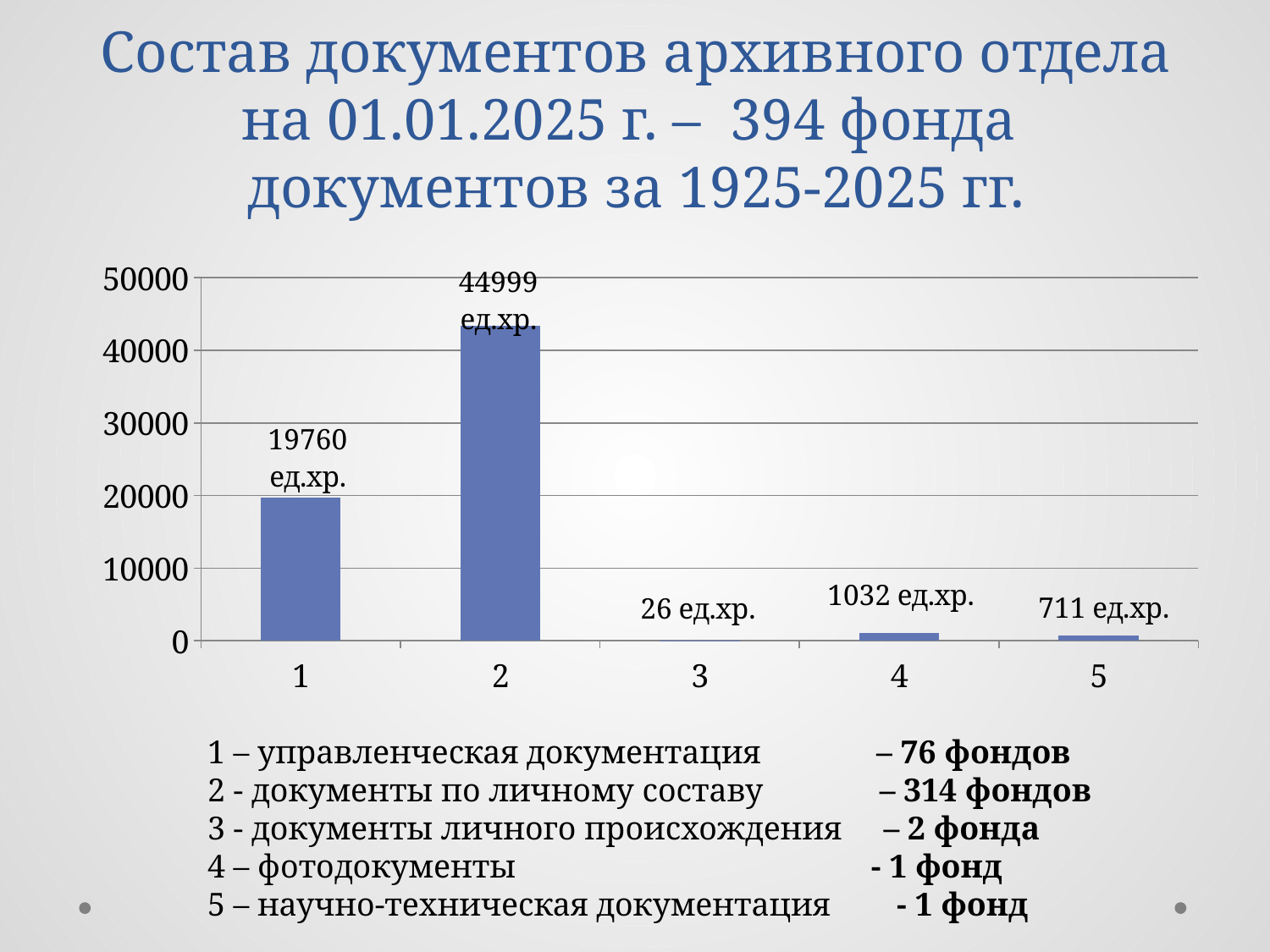
What is the value for category 1 in the bar chart? 19760 ед.хр. What is the value for category 3 in the bar chart? 26 ед.хр. What kind of chart is shown on the slide? bar chart What is the value for category 4 in the bar chart? 1032 ед.хр. How many categories are shown on the x axis of the bar chart? 5 According to the legend text below the chart, what does category 2 represent? документы по личному составу What is the difference between the values for category 2 and category 1? 25239 ед.хр. What is the value for category 5 in the bar chart? 711 ед.хр. Which is larger, the value for category 4 or the value for category 5? category 4 Which category has the highest value in the bar chart? 2 Which category has the lowest value in the bar chart? 3 What is the value for category 2 in the bar chart? 44999 ед.хр.